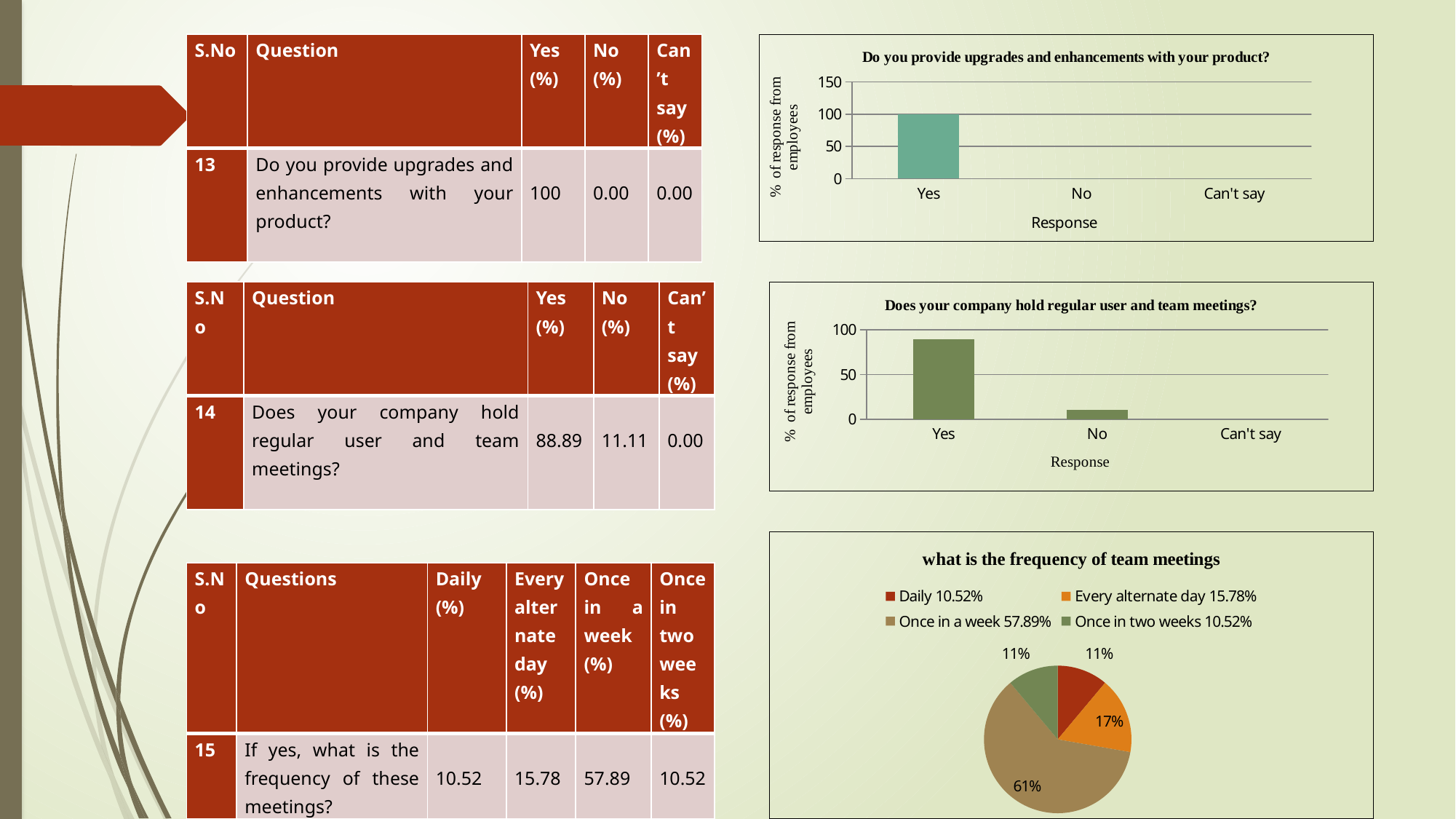
What type of chart is the chart titled "Do you provide upgrades and enhancements with your product?"? bar chart In the pie chart titled "what is the frequency of team meetings", what share is labelled for Once in a week? 61% In the chart titled "Does your company hold regular user and team meetings?", is the value for No greater or less than 50? less What type of chart is the chart titled "what is the frequency of team meetings"? pie chart In the chart titled "Does your company hold regular user and team meetings?", is the value for Yes greater or less than 50? greater In the chart titled "Do you provide upgrades and enhancements with your product?", what is the value for Yes? 100 In the chart titled "Does your company hold regular user and team meetings?", which response has the highest value? Yes In the chart titled "Does your company hold regular user and team meetings?", which is larger, the value for Yes or the value for No? Yes In the pie chart titled "what is the frequency of team meetings", which category has the smallest share according to the legend? Daily and Once in two weeks (10.52% each) In the chart titled "Do you provide upgrades and enhancements with your product?", how many response categories are shown on the x axis? 3 How many entries does the legend of the pie chart titled "what is the frequency of team meetings" list? 4 In the chart titled "Do you provide upgrades and enhancements with your product?", which response has the highest value? Yes